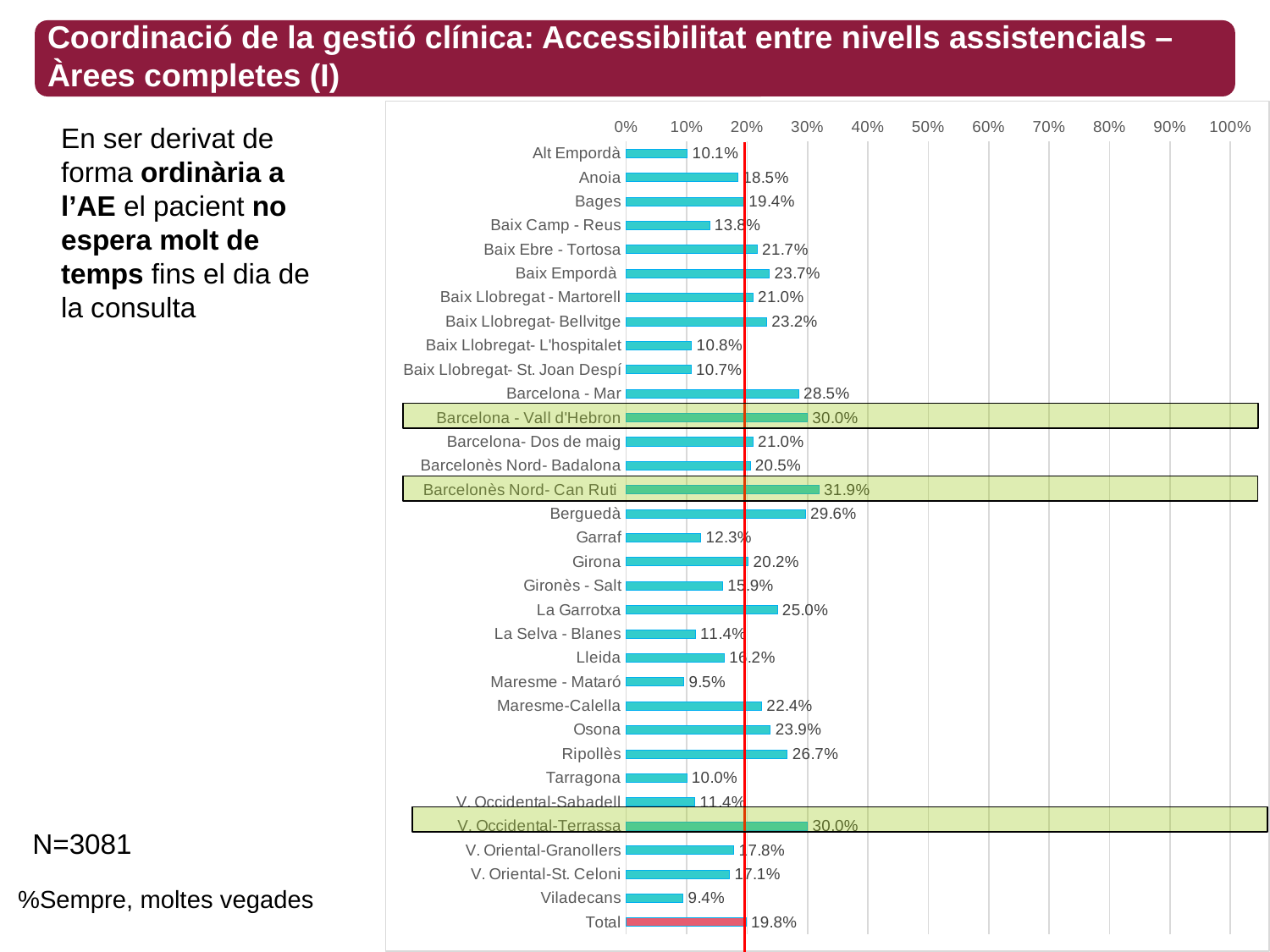
What kind of chart is shown on the slide? Horizontal bar chart Which area has the highest value? Barcelonès Nord- Can Ruti What is the difference between Barcelonès Nord- Can Ruti and the Total? 12.1 percentage points What is the sample size (N) stated on the slide? N=3081 Is the value for Osona greater or less than 20%? greater Which area has the lowest value? Viladecans Which is larger, the value for Berguedà or the value for La Garrotxa? Berguedà What is the value for Barcelona - Vall d'Hebron? 30.0% What is the value for Maresme - Mataró? 9.5% What is the value for Ripollès? 26.7% What is the difference between Barcelona - Mar and Alt Empordà? 18.4 percentage points What is the value for the Total bar? 19.8%